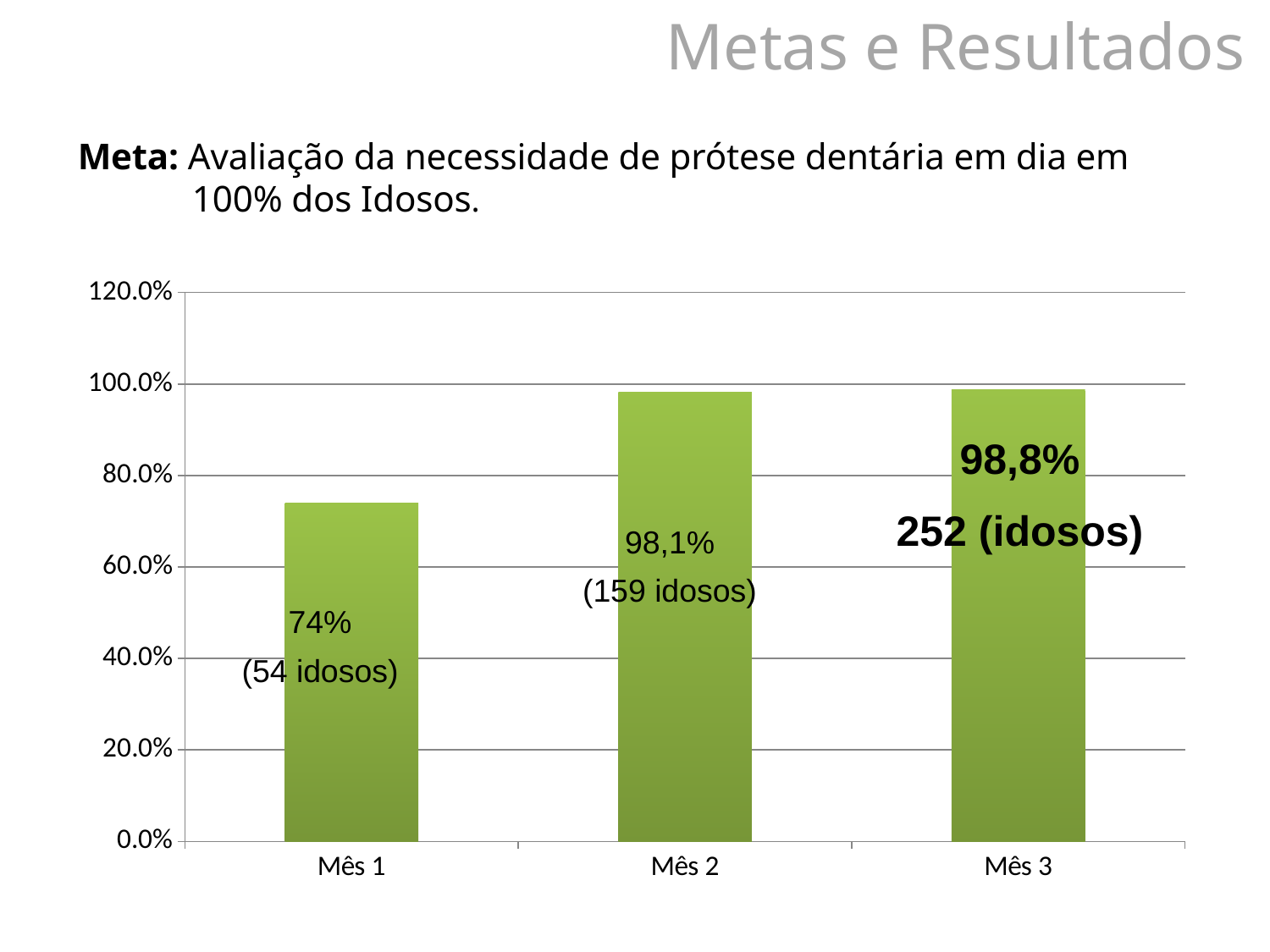
Is the value for Mês 1 greater or less than 80.0%? less Which month has the lowest percentage? Mês 1 What percentage is shown for Mês 1? 74% How many idosos are indicated for Mês 2? 159 Do the values rise or fall from Mês 1 to Mês 3? rise What kind of chart is shown on the slide? bar chart What percentage is shown for Mês 2? 98,1% Which month has the highest percentage according to the data labels? Mês 3 What is the difference in percentage points between Mês 2 and Mês 1? 24,1% How many idosos are indicated for Mês 3? 252 How many more idosos are indicated for Mês 3 than for Mês 2? 93 How many months (categories) are plotted on the chart? 3